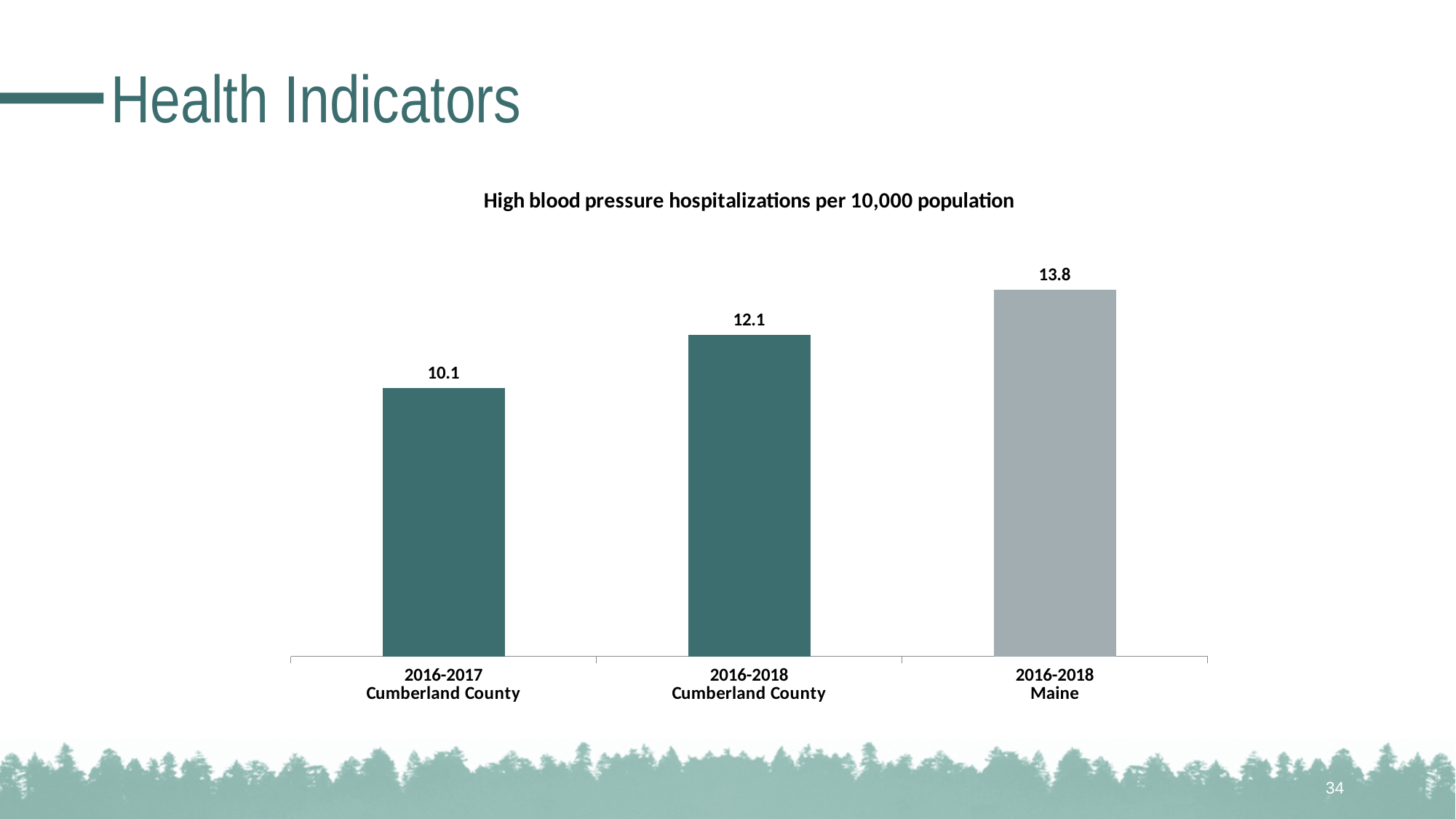
What is the value for 2016-2017 Cumberland County? 10.1 How many categories are shown on the chart? 3 What is the title of the chart? High blood pressure hospitalizations per 10,000 population What is the difference between the value for 2016-2018 Cumberland County and the value for 2016-2017 Cumberland County? 2.0 What kind of chart is shown on the slide? Bar chart What is the value for 2016-2018 Cumberland County? 12.1 Which category has the highest value? 2016-2018 Maine What is the value for 2016-2018 Maine? 13.8 Which is larger, the value for 2016-2018 Cumberland County or the value for 2016-2018 Maine? 2016-2018 Maine Which category has the lowest value? 2016-2017 Cumberland County Do the values rise or fall from left to right along the x axis? Rise What is the difference between the value for 2016-2018 Maine and the value for 2016-2018 Cumberland County? 1.7